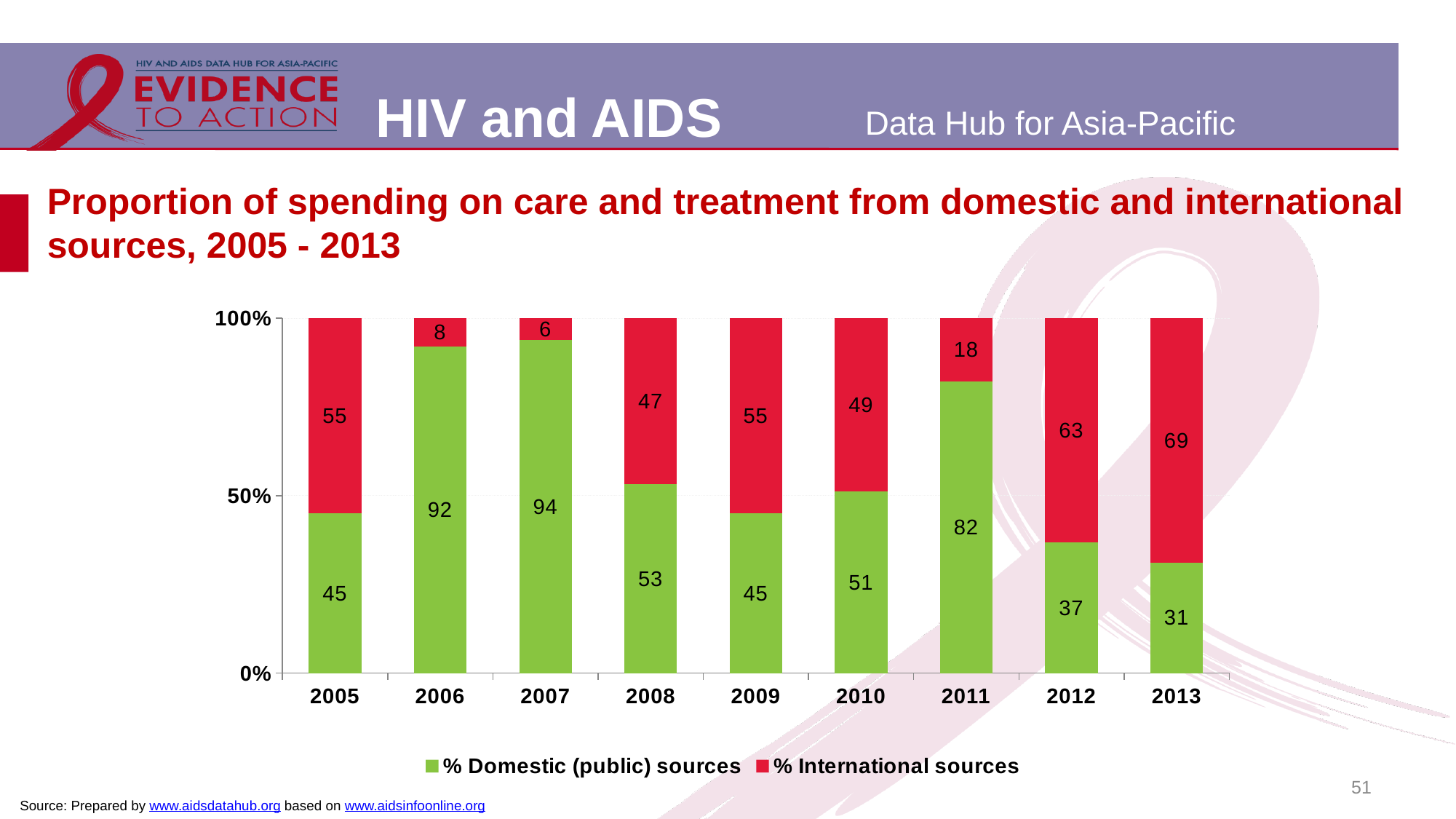
What kind of chart is shown on the slide? Stacked bar chart How many series does the legend list? 2 Which year has the lowest value for % Domestic (public) sources? 2013 What is the value for % Domestic (public) sources in 2007? 94 What is the difference between the % International sources values for 2013 and 2012? 6 How many years are shown on the x axis? 9 Which year has the lowest value for % International sources? 2007 Which is larger, the % Domestic (public) sources value for 2008 or for 2009? 2008 What is the value for % International sources in 2013? 69 Which year has the highest value for % Domestic (public) sources? 2007 Which colour represents % International sources in the chart? Red What is the value for % Domestic (public) sources in 2011? 82